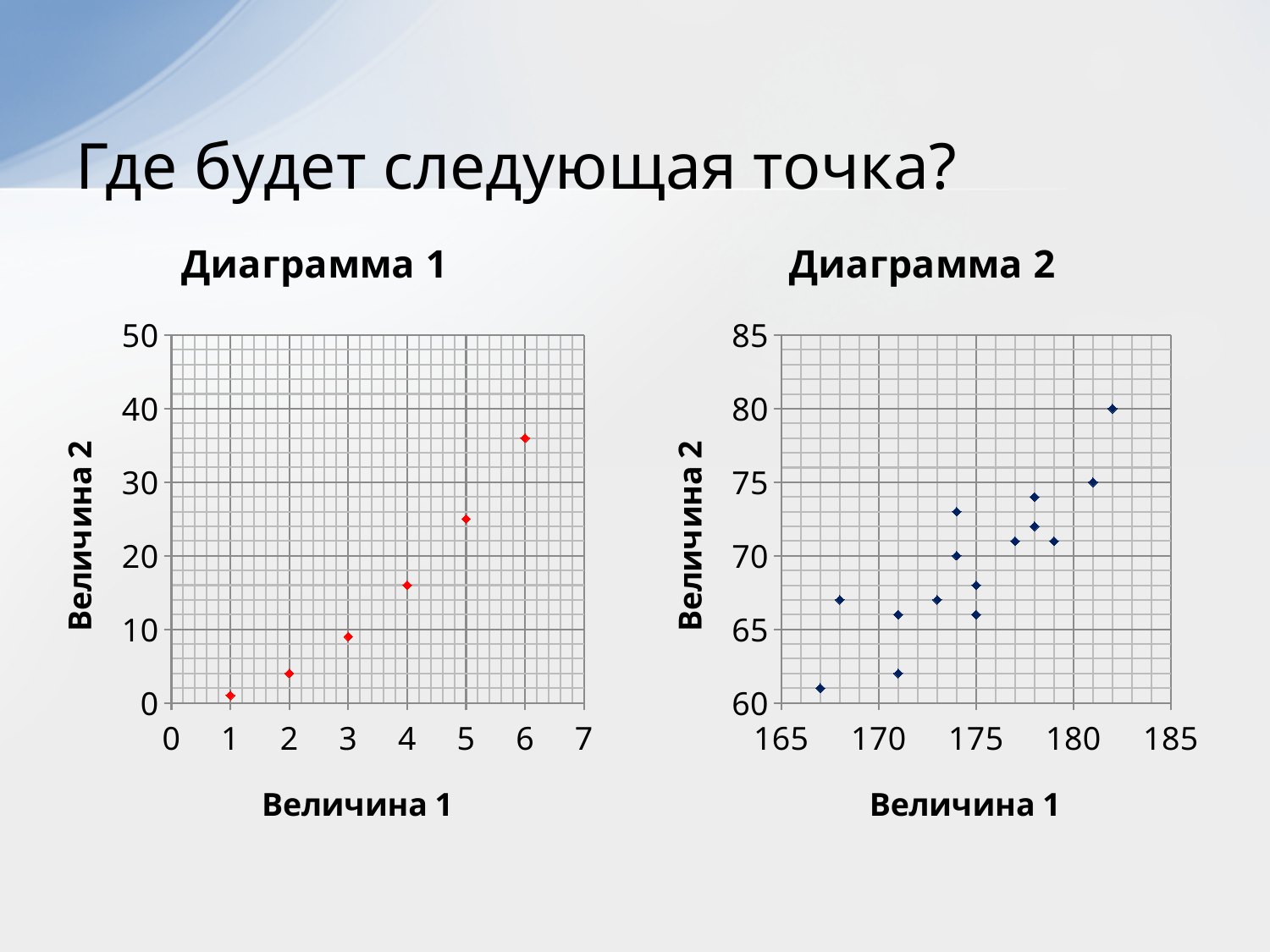
What is the label of the horizontal axis in Диаграмма 2? Величина 1 How many points are plotted in Диаграмма 1? 6 What kind of chart is Диаграмма 2? scatter chart What kind of chart is Диаграмма 1? scatter chart In Диаграмма 2, is the lowest plotted value of Величина 2 greater or less than 65? less In Диаграмма 1, at which value of Величина 1 is Величина 2 lowest? 1 In Диаграмма 2, do the values of Величина 2 generally rise or fall as Величина 1 increases? rise In Диаграмма 1, at which value of Величина 1 is Величина 2 highest? 6 In Диаграмма 1, do the values of Величина 2 rise or fall as Величина 1 increases? rise In Диаграмма 2, is the highest plotted value of Величина 2 greater or less than 75? greater In Диаграмма 1, is the value of Величина 2 at Величина 1 = 6 greater or less than 30? greater